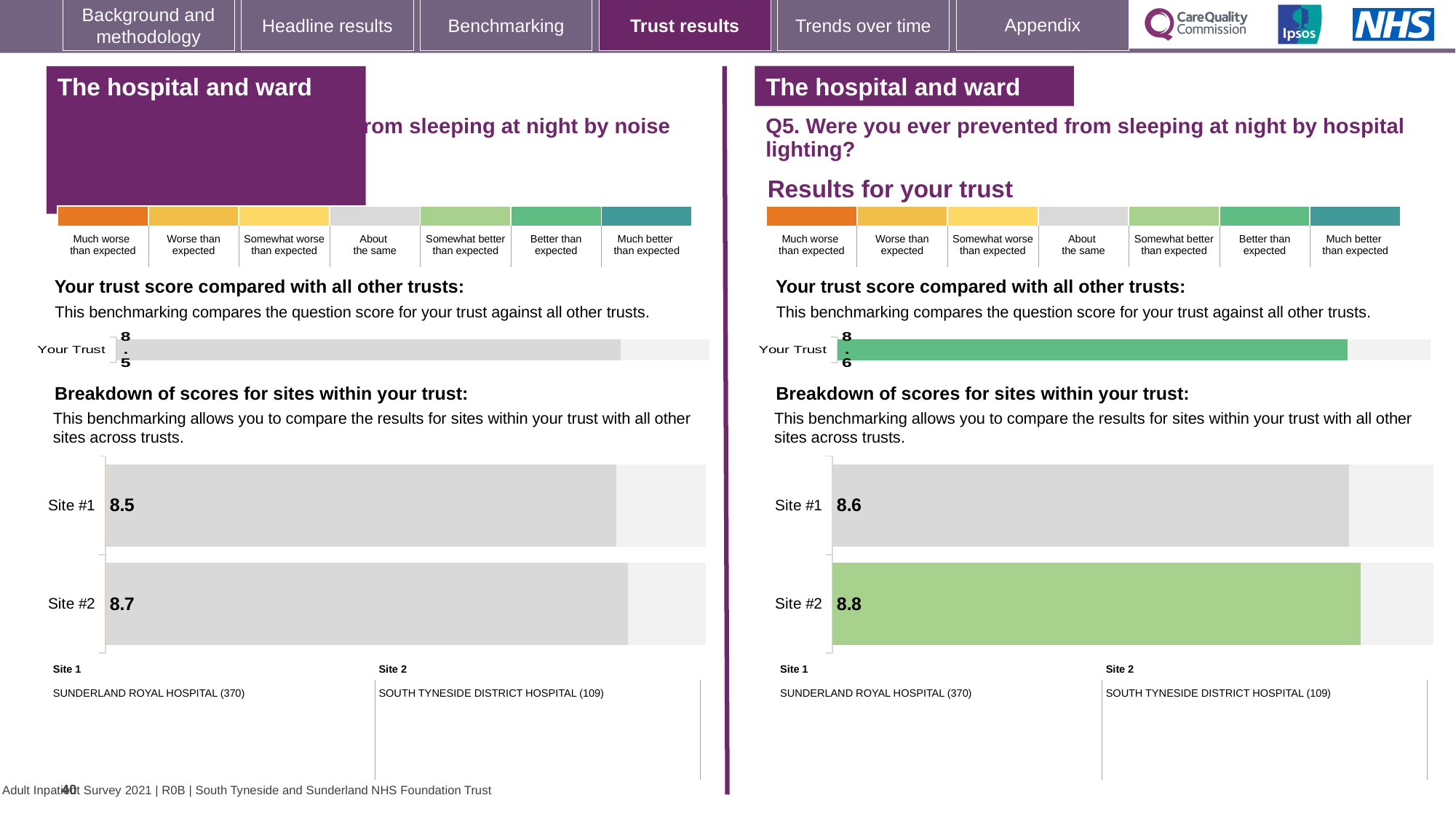
On the left-hand chart (sleeping at night by noise), which site has the lower score? Site #1 What type of chart is used for the breakdown of scores for sites on the right-hand side (Q5, hospital lighting)? Bar chart On the right-hand chart (Q5, hospital lighting), what is the score for Site #1? 8.6 On the right-hand chart (Q5, hospital lighting), what is the 'Your Trust' score? 8.6 On the left-hand chart (sleeping at night by noise), what is the difference between the Site #2 and Site #1 scores? 0.2 On the right-hand chart (Q5, hospital lighting), what is the score for Site #2? 8.8 On the right-hand chart (Q5, hospital lighting), which site has the higher score? Site #2 How many sites are shown in the site breakdown chart on the right-hand side (Q5, hospital lighting)? 2 On the right-hand chart (Q5, hospital lighting), what is the difference between the Site #2 and Site #1 scores? 0.2 On the left-hand chart (sleeping at night by noise), what is the 'Your Trust' score? 8.5 On the left-hand chart (sleeping at night by noise), what is the score for Site #1? 8.5 On the left-hand chart (sleeping at night by noise), what is the score for Site #2? 8.7